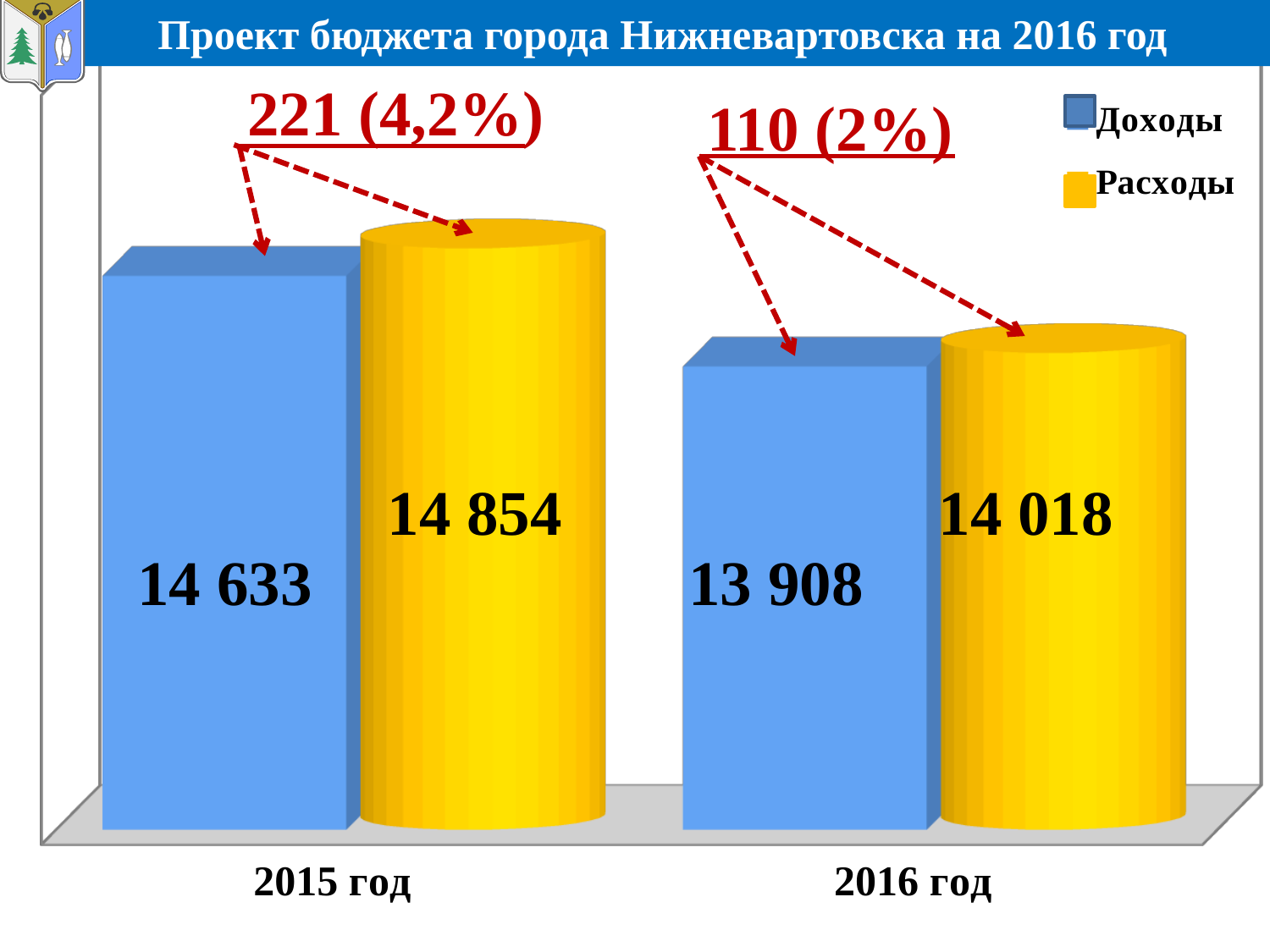
Which is larger for 2016 год, Доходы or Расходы? Расходы What is the difference between Расходы and Доходы for 2016 год? 110 Do the Доходы values rise or fall from 2015 год to 2016 год? Fall What kind of chart is shown on the slide? Bar chart Which bar has the lowest value on the chart? Доходы, 2016 год Which bar has the highest value on the chart? Расходы, 2015 год What is the value of Доходы for 2016 год? 13 908 What is the value of Доходы for 2015 год? 14 633 What is the difference between Расходы and Доходы for 2015 год? 221 What is the value of Расходы for 2015 год? 14 854 What is the value of Расходы for 2016 год? 14 018 How many series does the legend list? 2